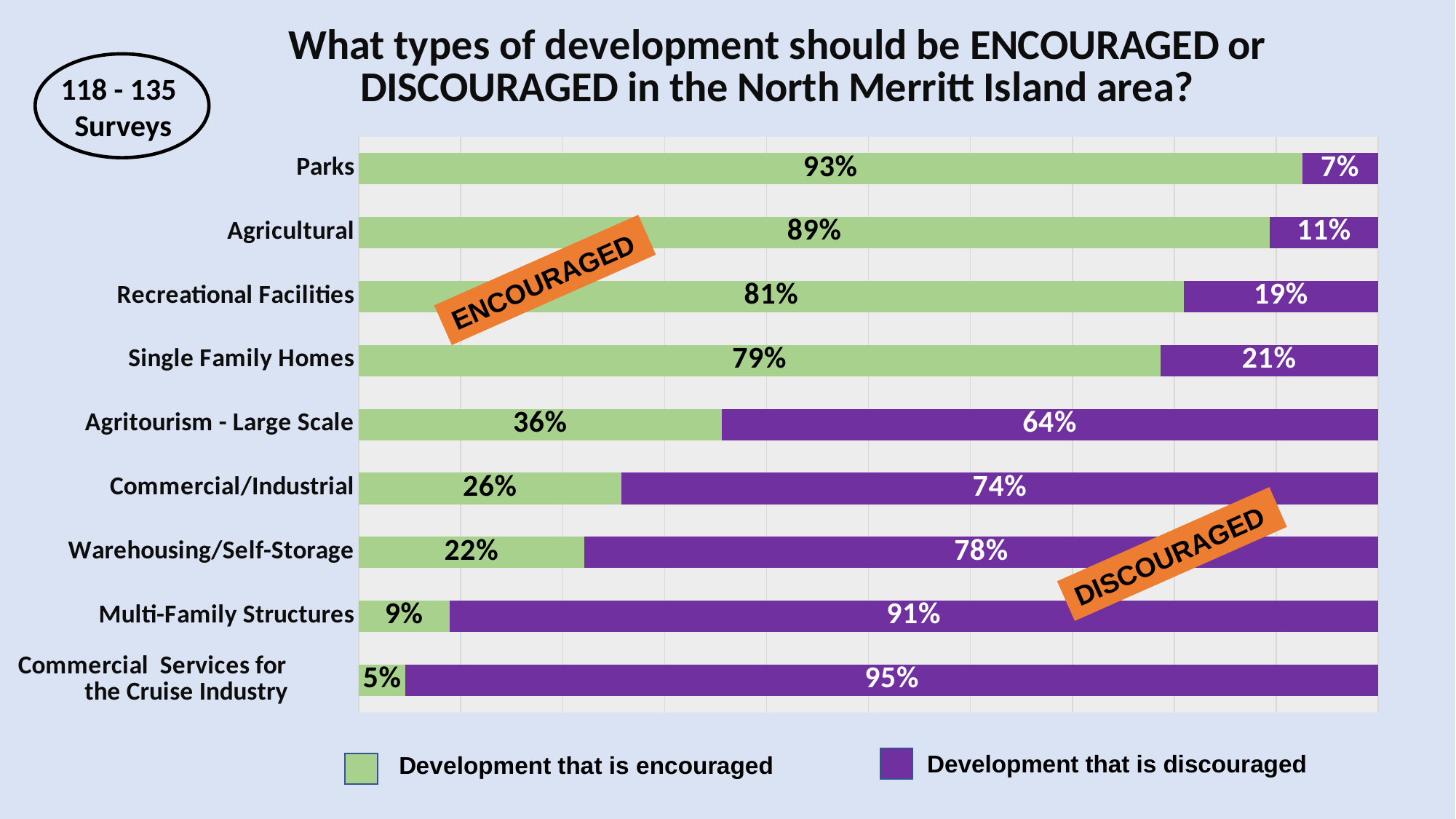
Which development type has the highest encouraged percentage? Parks Which development type has the lowest encouraged percentage? Commercial Services for the Cruise Industry What percentage of respondents said Parks development should be encouraged? 93% What is the encouraged percentage for Agritourism - Large Scale? 36% What colour represents development that is discouraged? Purple What kind of chart is shown on the slide? Stacked bar chart Which development type has the highest discouraged percentage? Commercial Services for the Cruise Industry What is the difference between the encouraged percentages for Agricultural and Single Family Homes? 10% Which has a larger discouraged percentage, Warehousing/Self-Storage or Multi-Family Structures? Multi-Family Structures How many series does the legend list? 2 How many development types are shown in the chart? 9 What percentage of respondents said Commercial/Industrial development should be discouraged? 74%